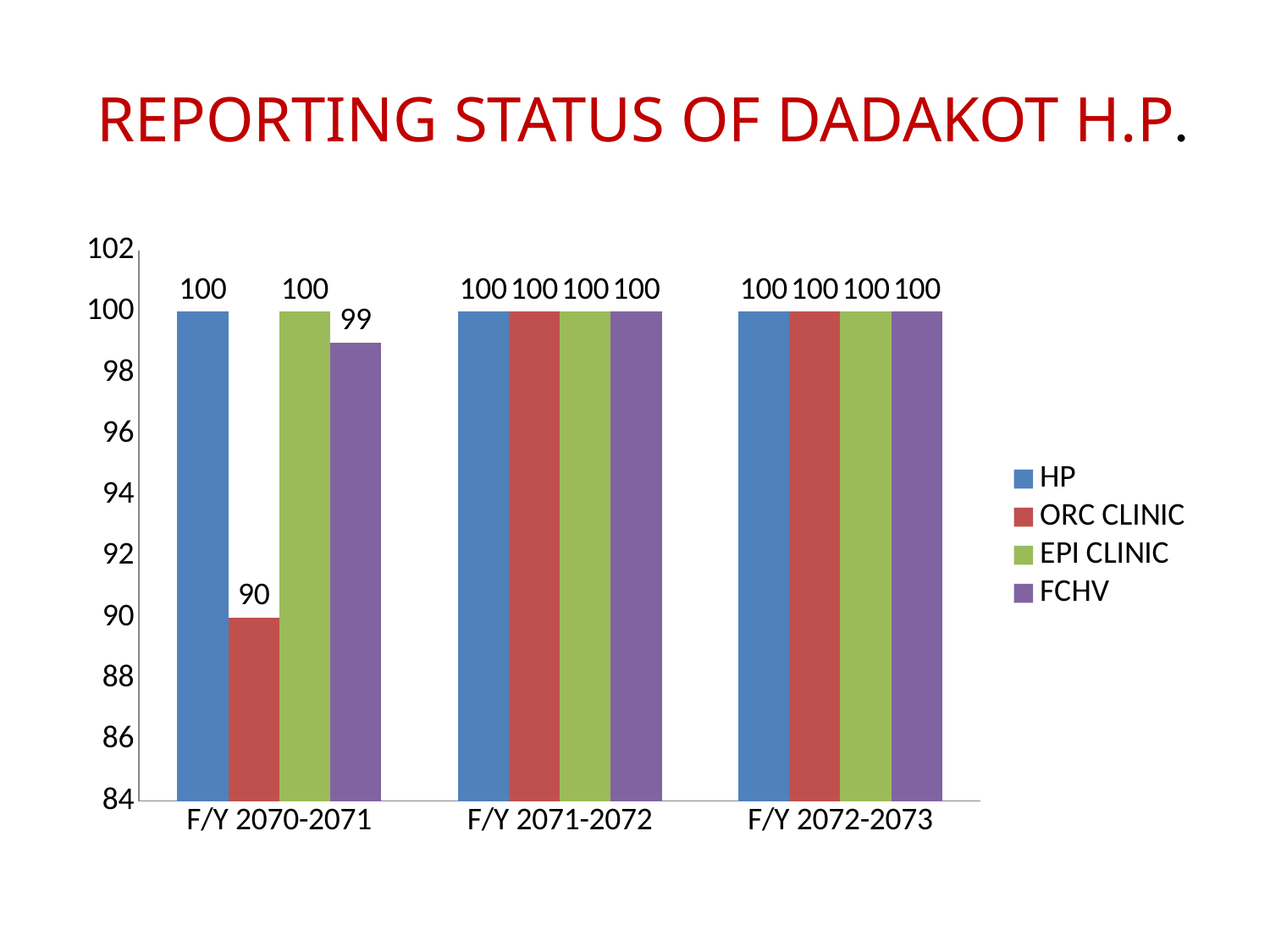
What is the value for HP in F/Y 2072-2073? 100 What kind of chart is shown on the slide? bar chart What is the value for FCHV in F/Y 2070-2071? 99 What is the title of the chart? REPORTING STATUS OF DADAKOT H.P. How many fiscal year categories are shown on the x axis? 3 What is the difference between the EPI CLINIC value and the FCHV value in F/Y 2070-2071? 1 How many series does the legend list? 4 Which series has the lowest value in F/Y 2070-2071? ORC CLINIC Is the value for ORC CLINIC in F/Y 2070-2071 greater or less than 92? less Which is larger in F/Y 2070-2071, the value for FCHV or the value for ORC CLINIC? FCHV What is the difference between the HP value and the ORC CLINIC value in F/Y 2070-2071? 10 What is the value for ORC CLINIC in F/Y 2070-2071? 90